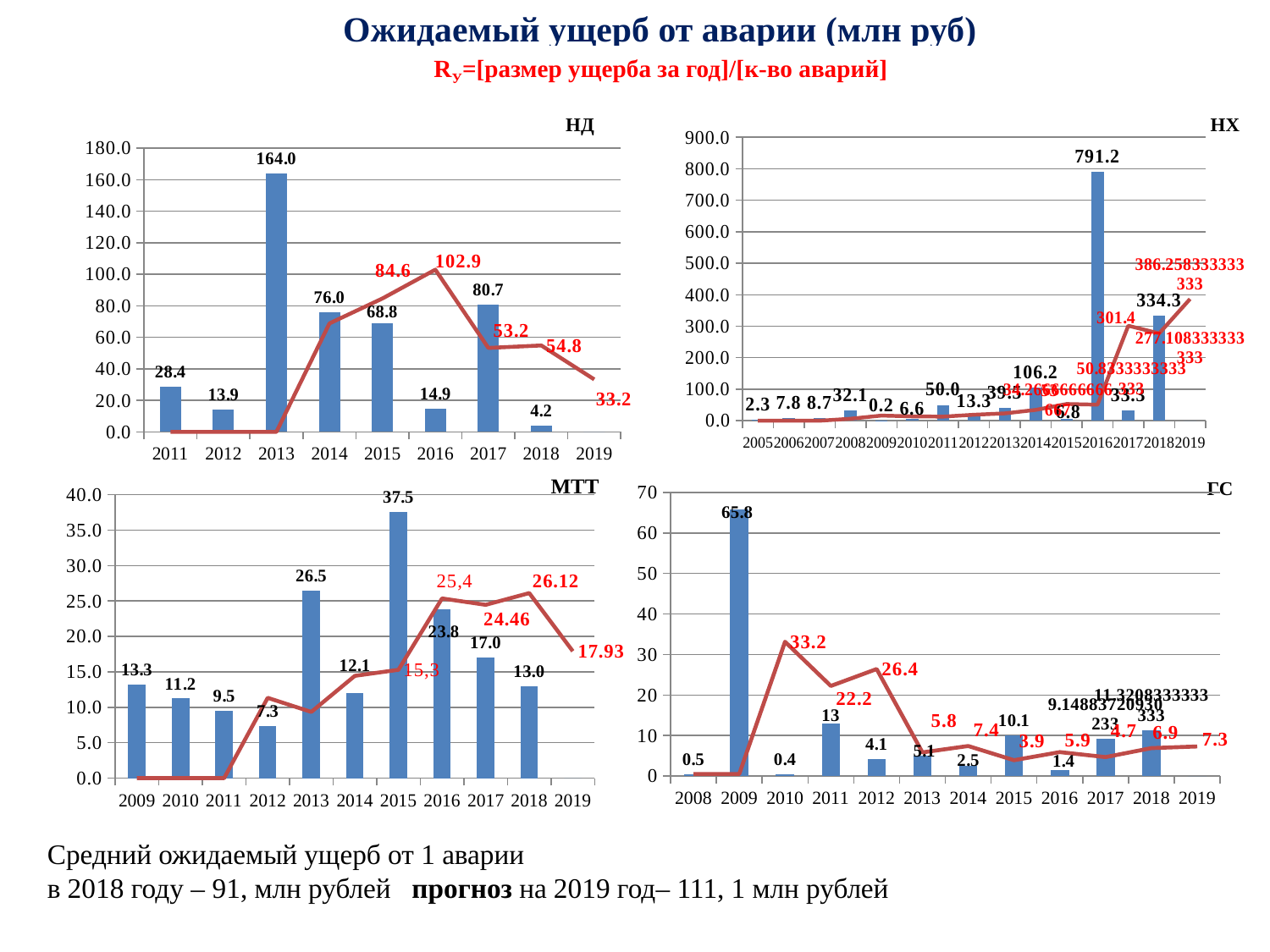
On the НД chart (top left), which year has the lowest bar? 2018 On the ГС chart (bottom right), which year has the highest bar? 2009 On the МТТ chart (bottom left), which bar is larger, 2009 or 2010? 2009 On the НД chart (top left), what is the value of the bar for 2013? 164.0 On the МТТ chart (bottom left), what is the value of the bar for 2013? 26.5 On the МТТ chart (bottom left), which year has the highest bar? 2015 On the НД chart (top left), which year has the highest bar? 2013 On the НД chart (top left), what is the difference between the bar values for 2017 and 2015? 11.9 On the НХ chart (top right), what is the value of the bar for 2016? 791.2 On the НД chart (top left), what is the value of the red line for 2016? 102.9 On the ГС chart (bottom right), what is the value of the red line for 2010? 33.2